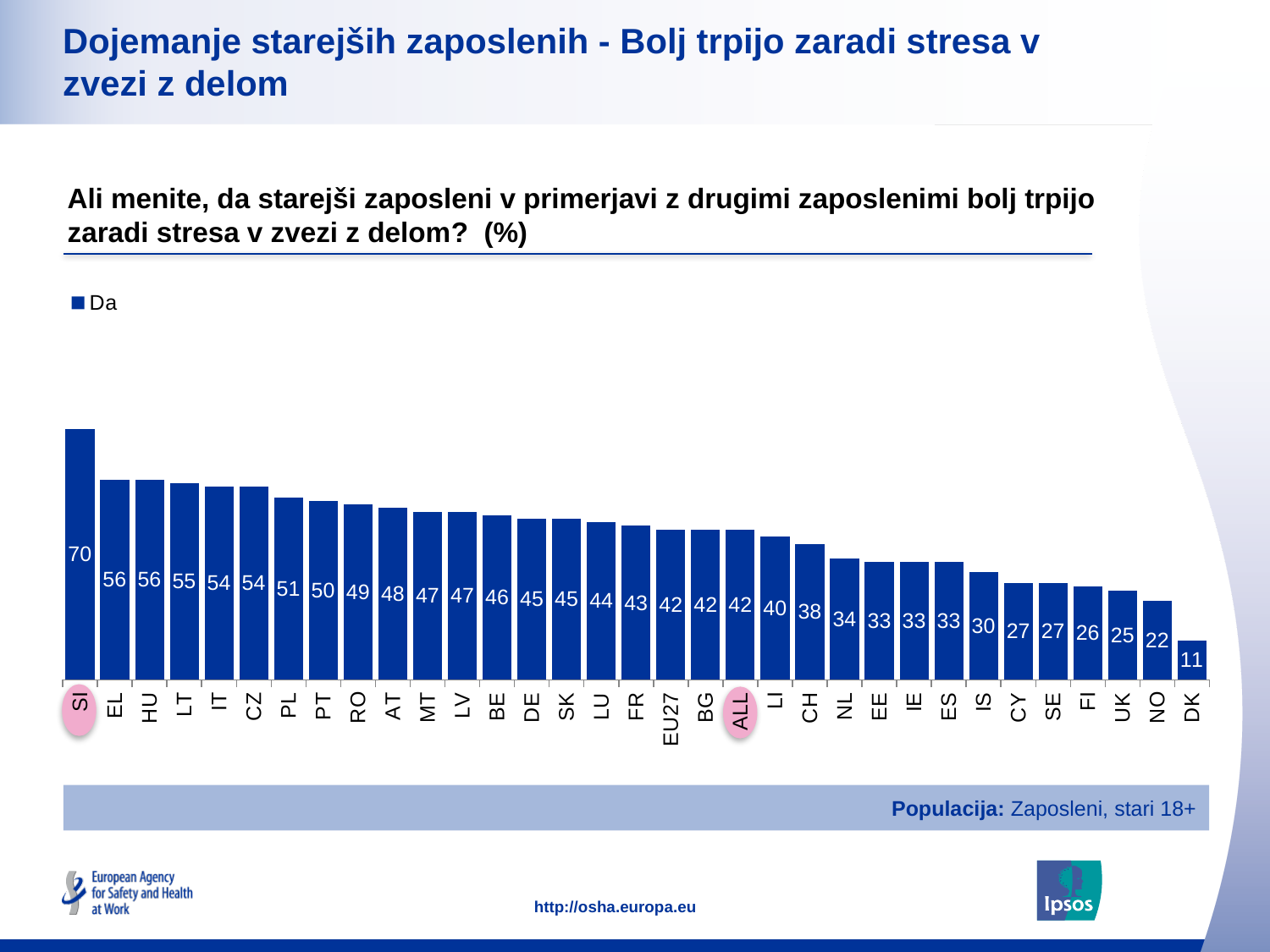
How many series does the legend list? 1 What kind of chart is shown on the slide? Bar chart What is the value for EU27? 42 What is the value for SI? 70 How many categories are shown on the x axis? 33 What is the difference between the values for PL and NL? 17 What is the value for CH? 38 Which category has the lowest value? DK Which is larger, the value for LT or the value for IS? LT What is the value for DK? 11 Which category has the highest value? SI What is the difference between the values for SI and DK? 59